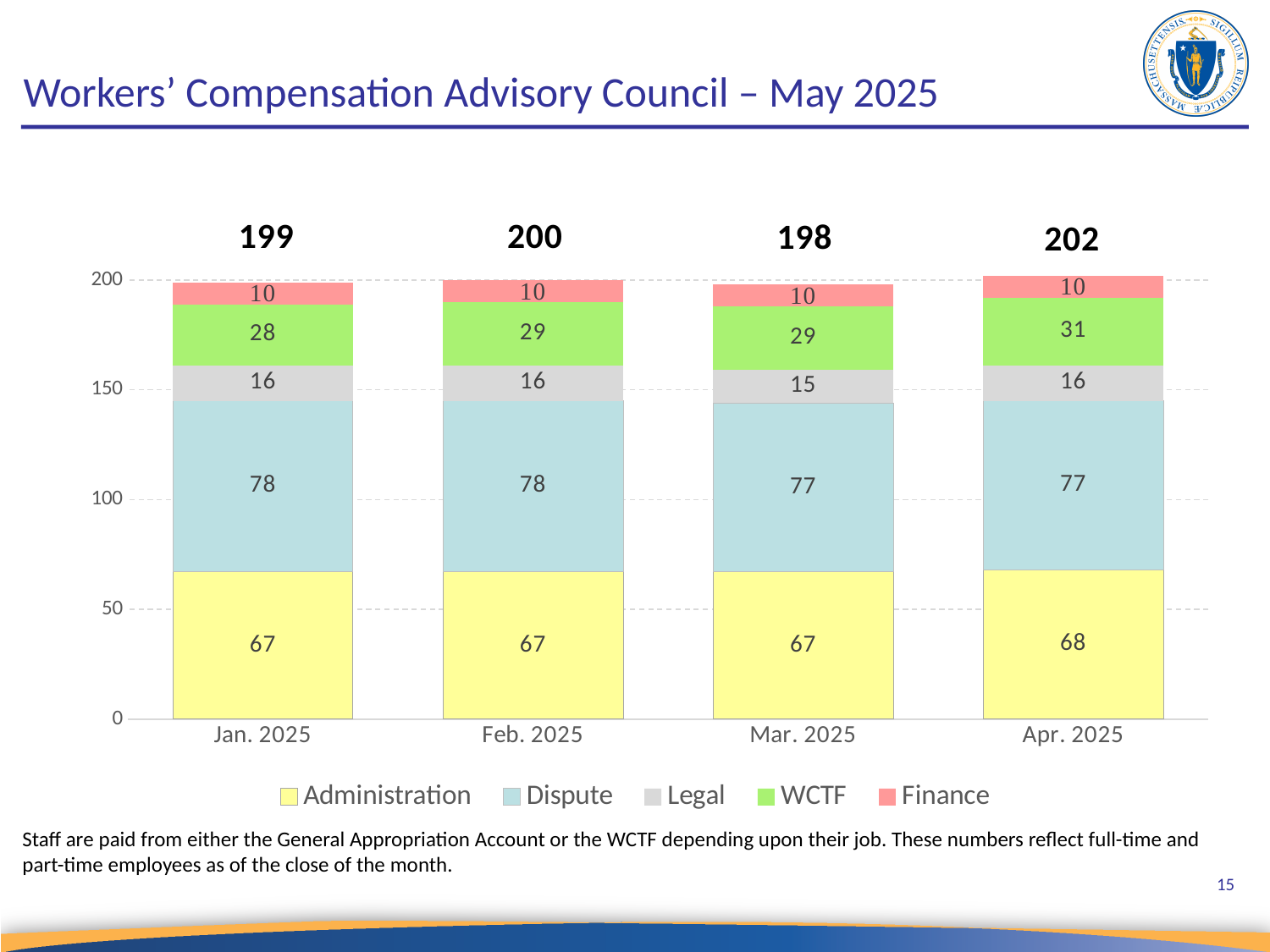
What is the difference between the WCTF values for Apr. 2025 and Jan. 2025? 3 What is the Dispute value for Jan. 2025? 78 How many months are shown on the x axis? 4 What is the Legal value for Mar. 2025? 15 What is the WCTF value for Apr. 2025? 31 What kind of chart is shown on the slide? stacked bar chart How many series does the legend list? 5 Which month has the lowest stacked bar total? Mar. 2025 What is the Administration value for Feb. 2025? 67 Is the Administration value for Apr. 2025 larger or smaller than the Administration value for Mar. 2025? larger What is the total of the stacked bar for Apr. 2025? 202 Which month has the highest stacked bar total? Apr. 2025